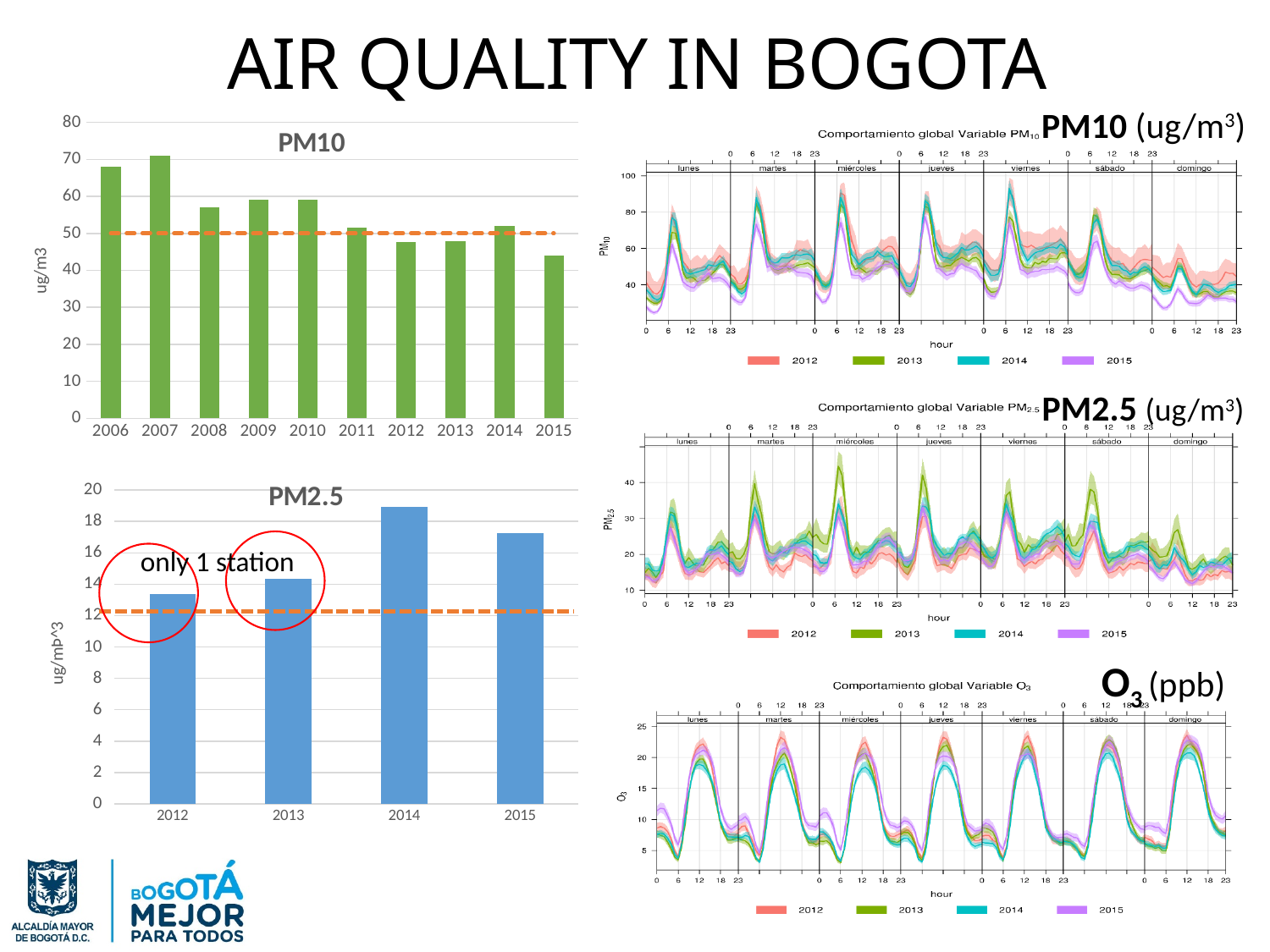
In the PM10 bar chart on the left, is the value for 2006 greater or less than 60? greater In the PM2.5 bar chart on the left, which is larger, the value for 2014 or the value for 2015? 2014 In the PM2.5 bar chart on the left, which year has the highest value? 2014 In the PM10 bar chart on the left, is the value for 2015 greater or less than 50? less In the PM10 bar chart on the left, which year has the lowest value? 2015 In the PM10 bar chart on the left, which year has the highest value? 2007 In the PM2.5 bar chart on the left, which year has the lowest value? 2012 How many years are shown in the PM10 bar chart on the left? 10 In the PM10 bar chart on the left, do the values generally rise or fall from 2006 to 2015? fall In the PM2.5 bar chart on the left, is the value for 2014 greater or less than 18? greater What kind of chart is the PM10 chart on the left of the slide? bar chart How many series does the legend list in the O3 (ppb) line chart at the bottom right? 4